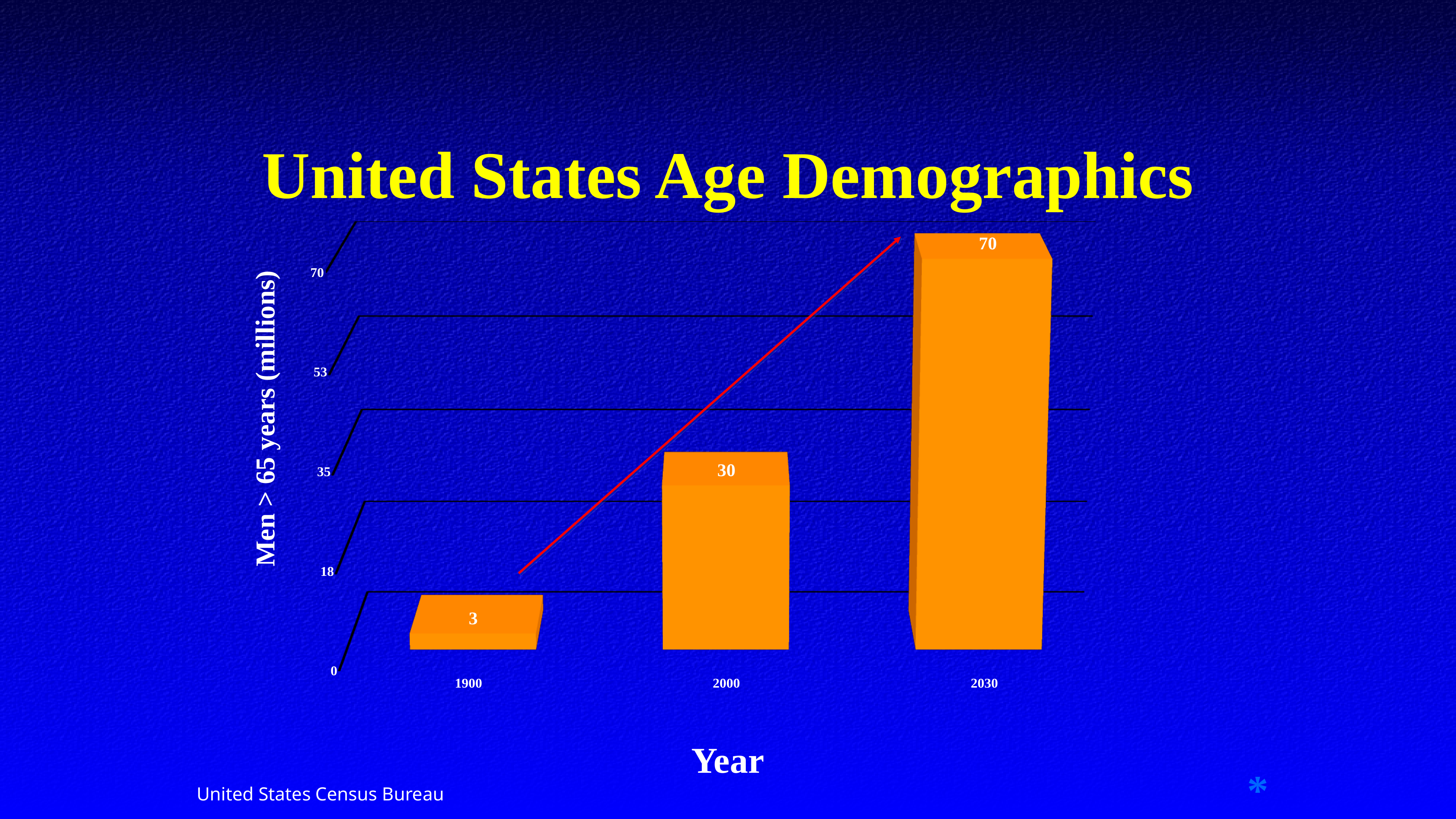
What is the difference between the values for 2030 and 2000? 40 Which year has the highest value? 2030 What is the difference between the values for 2000 and 1900? 27 What is the title of the chart? United States Age Demographics What is the value for 2030? 70 Which year has the lowest value? 1900 Do the values rise or fall from 1900 to 2030? rise How many years are shown on the x axis? 3 Which is larger, the value for 2000 or the value for 1900? 2000 What is the value for 1900? 3 What kind of chart is this? bar chart What is the value for 2000? 30